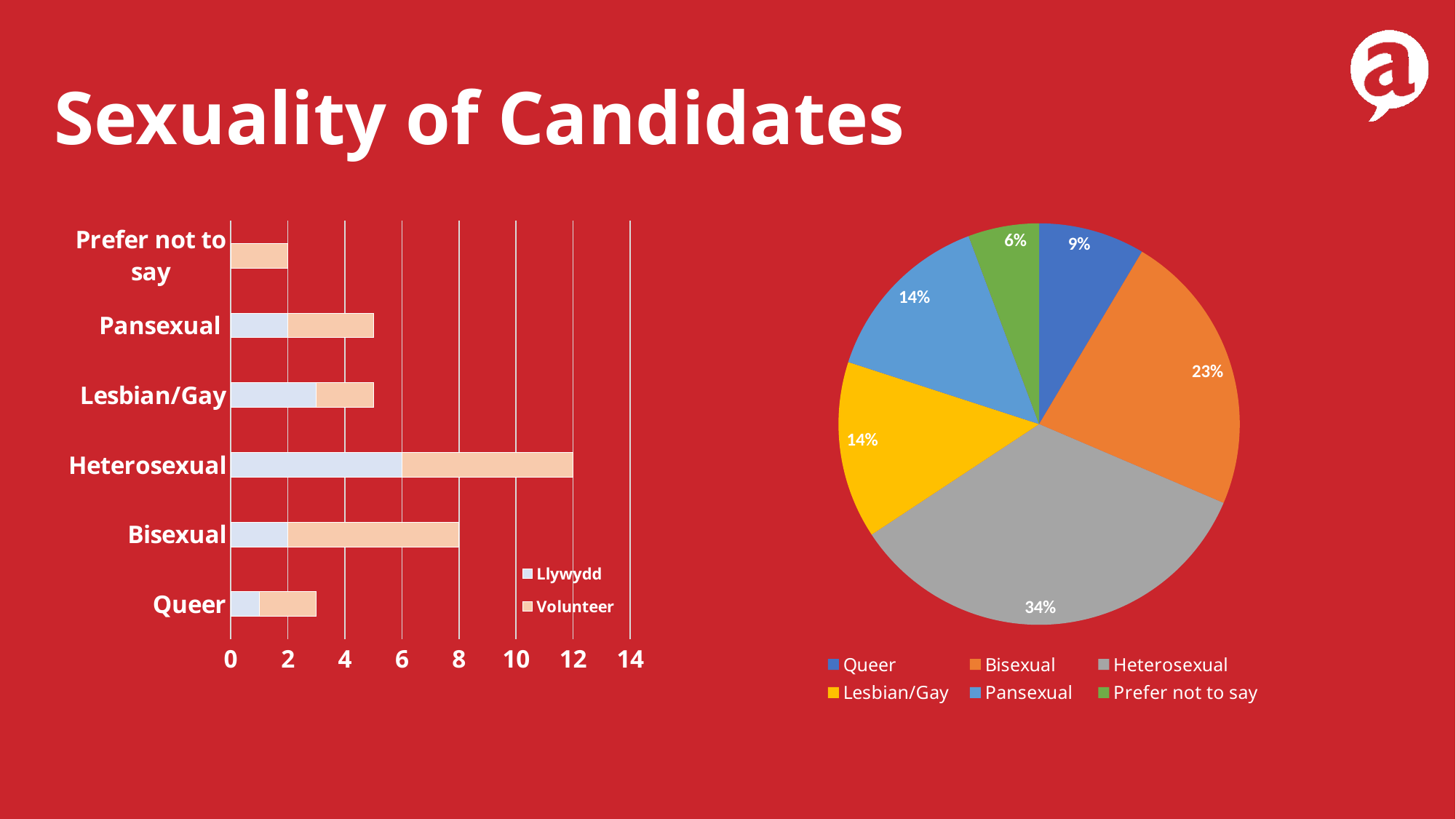
How many series does the legend of the bar chart on the left list? 2 In the pie chart, what share is labelled for Heterosexual? 34% What kind of chart is on the left side of the slide? Bar chart In the pie chart, what is the difference in percentage points between the Bisexual and Queer slices? 14 In the pie chart, which category has the largest slice? Heterosexual In the bar chart on the left, what is the total length of the Heterosexual bar? 12 In the bar chart on the left, which category has the longest bar? Heterosexual How many categories does the pie chart's legend list? 6 In the pie chart, which category has the smallest slice? Prefer not to say In the pie chart, what share is labelled for Prefer not to say? 6% In the pie chart, what share is labelled for Bisexual? 23% In the bar chart on the left, is the total for Lesbian/Gay greater or less than 4? greater